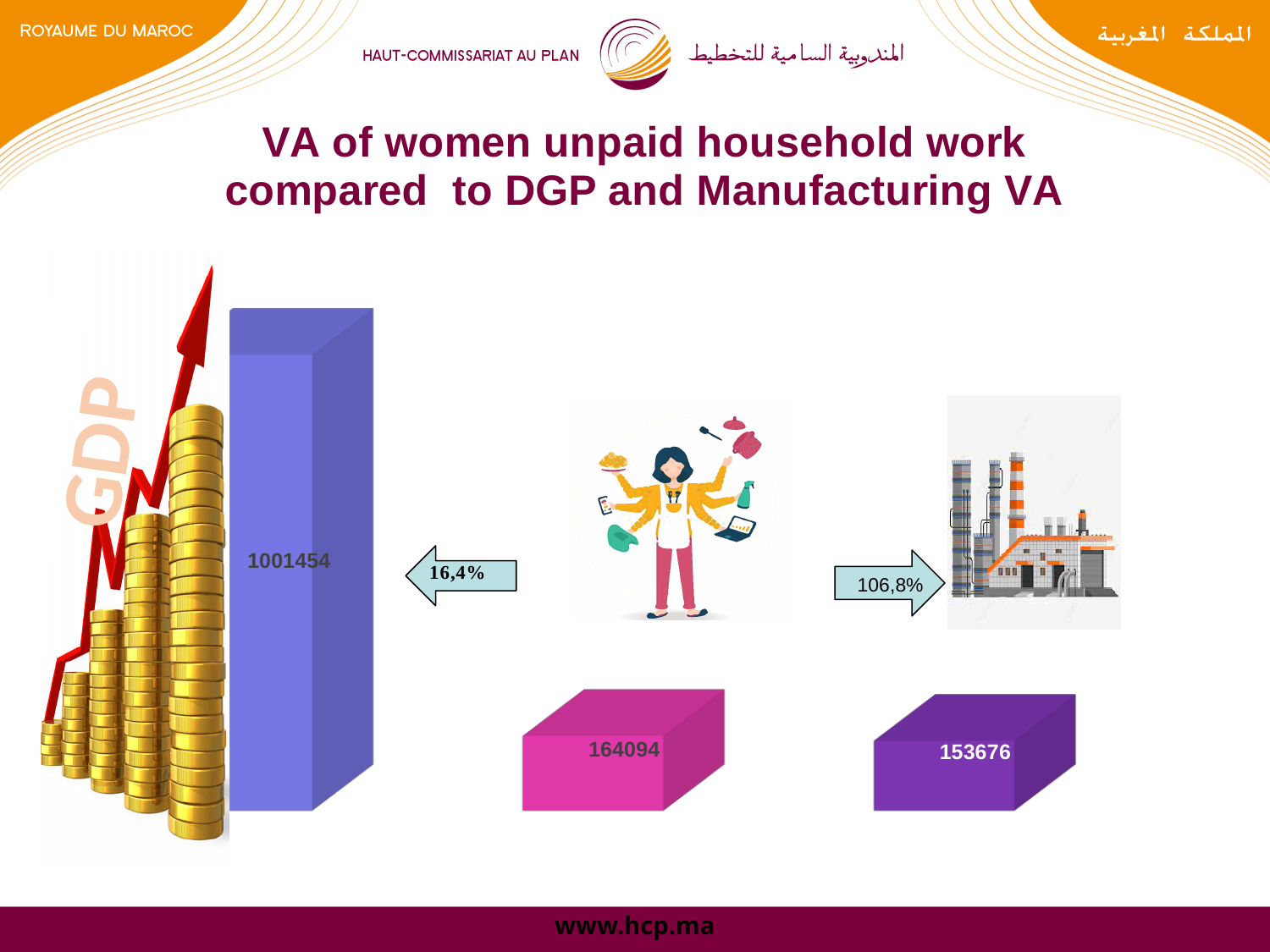
What value is printed on the pink bar in the middle, below the woman illustration? 164094 How many bars are shown on the slide? 3 Which bar has the lowest value, the pink middle bar or the purple right bar? The purple right bar (153676) What is the difference between the pink middle bar (164094) and the purple right bar (153676)? 10418 What kind of chart is shown on the slide? Bar chart What percentage is shown in the arrow pointing from the woman illustration toward the GDP bar? 16,4% Which is larger, the value on the pink middle bar or the value on the purple right bar? The pink middle bar (164094) What percentage is shown in the arrow pointing toward the factory illustration? 106,8% What value is printed on the tall blue bar labelled GDP? 1001454 Which of the three bars has the highest value? GDP What value is printed on the purple bar on the right, below the factory illustration? 153676 What is the difference between the GDP value and the pink middle bar's value? 837360